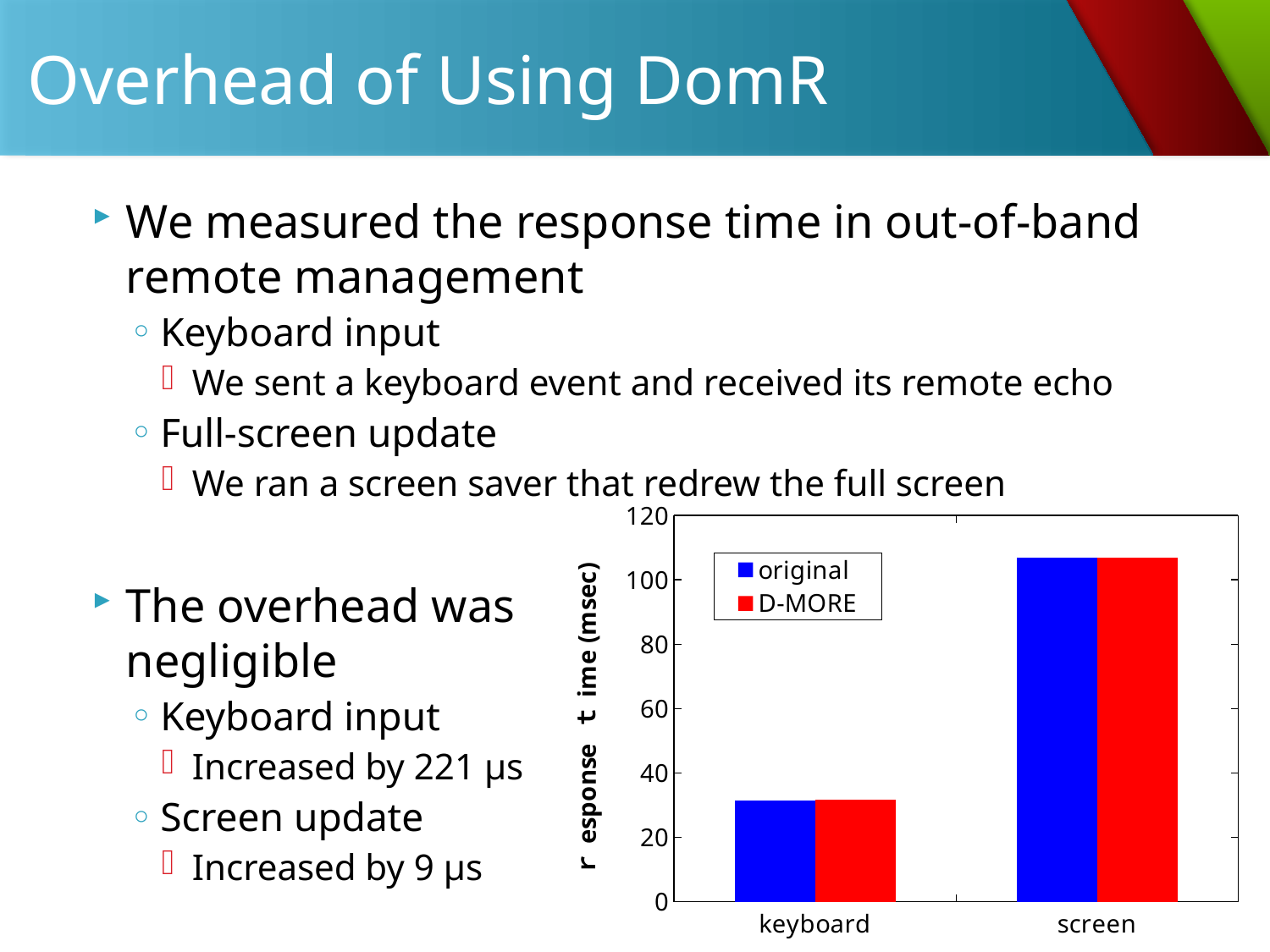
How many series does the chart's legend list? 2 How many categories are shown on the x axis of the chart? 2 Is the D-MORE response time for screen greater or less than 120? less What kind of chart is shown on the slide? bar chart Is the original response time for keyboard greater or less than 40? less What colour are the bars for the D-MORE series? red Is the original response time for screen greater or less than 100? greater What are the two series listed in the chart's legend? original and D-MORE Which category has the lowest response time in the chart? keyboard For the original series, which category has the larger response time, keyboard or screen? screen Which category has the highest response time in the chart? screen